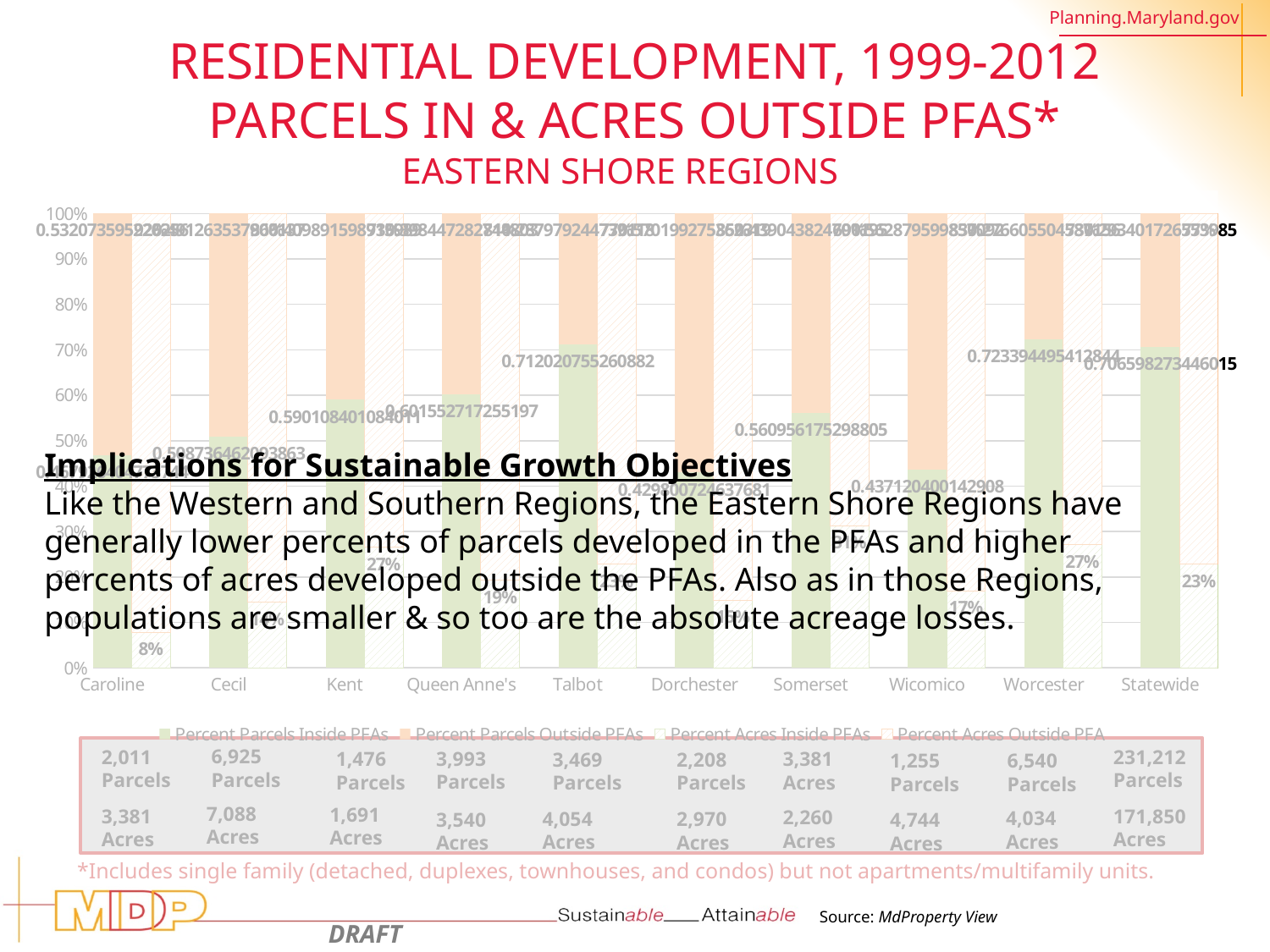
Is the Percent Parcels Inside PFAs value for Caroline greater or less than 60%? less Is the Percent Parcels Inside PFAs value for Wicomico greater or less than 50%? less What is the first series listed in the chart legend? Percent Parcels Inside PFAs How many series does the chart legend list? 4 Which has the larger Percent Parcels Inside PFAs value, Worcester or Wicomico? Worcester What kind of chart is shown on the slide? Stacked bar chart Which category appears last (rightmost) on the chart's x axis? Statewide Which has the larger Percent Parcels Inside PFAs value, Talbot or Caroline? Talbot What is the highest value shown on the chart's y axis? 100% Is the Percent Parcels Inside PFAs value for Worcester greater or less than 60%? greater How many regions (categories) are shown along the x axis of the chart? 10